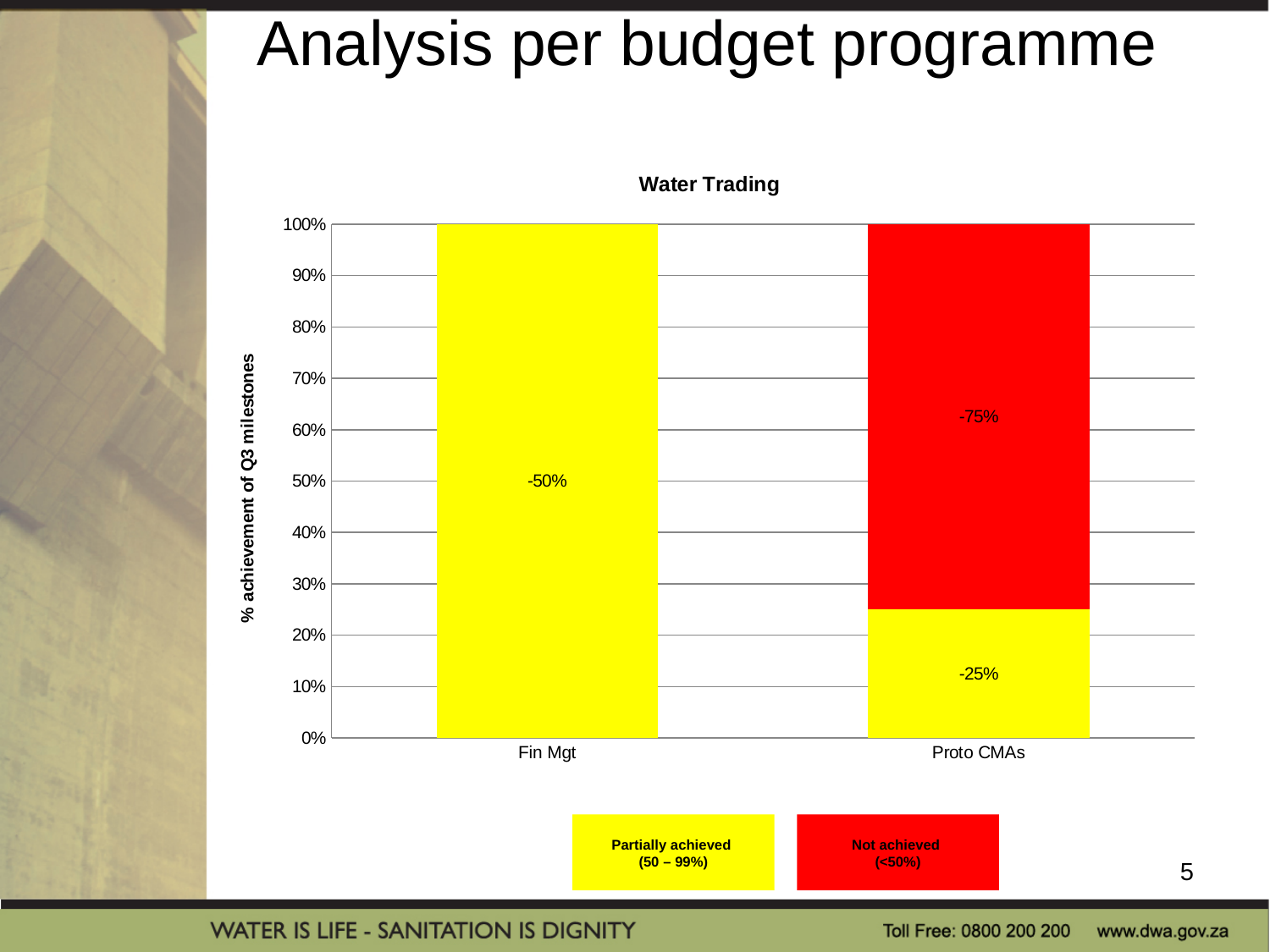
Is the top of the yellow segment for Proto CMAs greater or less than 30%? less How many entries does the legend below the chart list? 2 What data label is printed on the yellow bar for Fin Mgt? -50% How many categories are shown on the x axis of the chart? 2 Is the top of the yellow bar for Fin Mgt greater or less than 90%? greater Which category has a red 'Not achieved' segment in its bar? Proto CMAs What is the title of the chart? Water Trading What data label is printed on the red segment for Proto CMAs? -75% What kind of chart is shown on the slide? Stacked bar chart What is the label of the y axis? % achievement of Q3 milestones What data label is printed on the yellow segment for Proto CMAs? -25% Which category's bar has the larger red segment, Fin Mgt or Proto CMAs? Proto CMAs